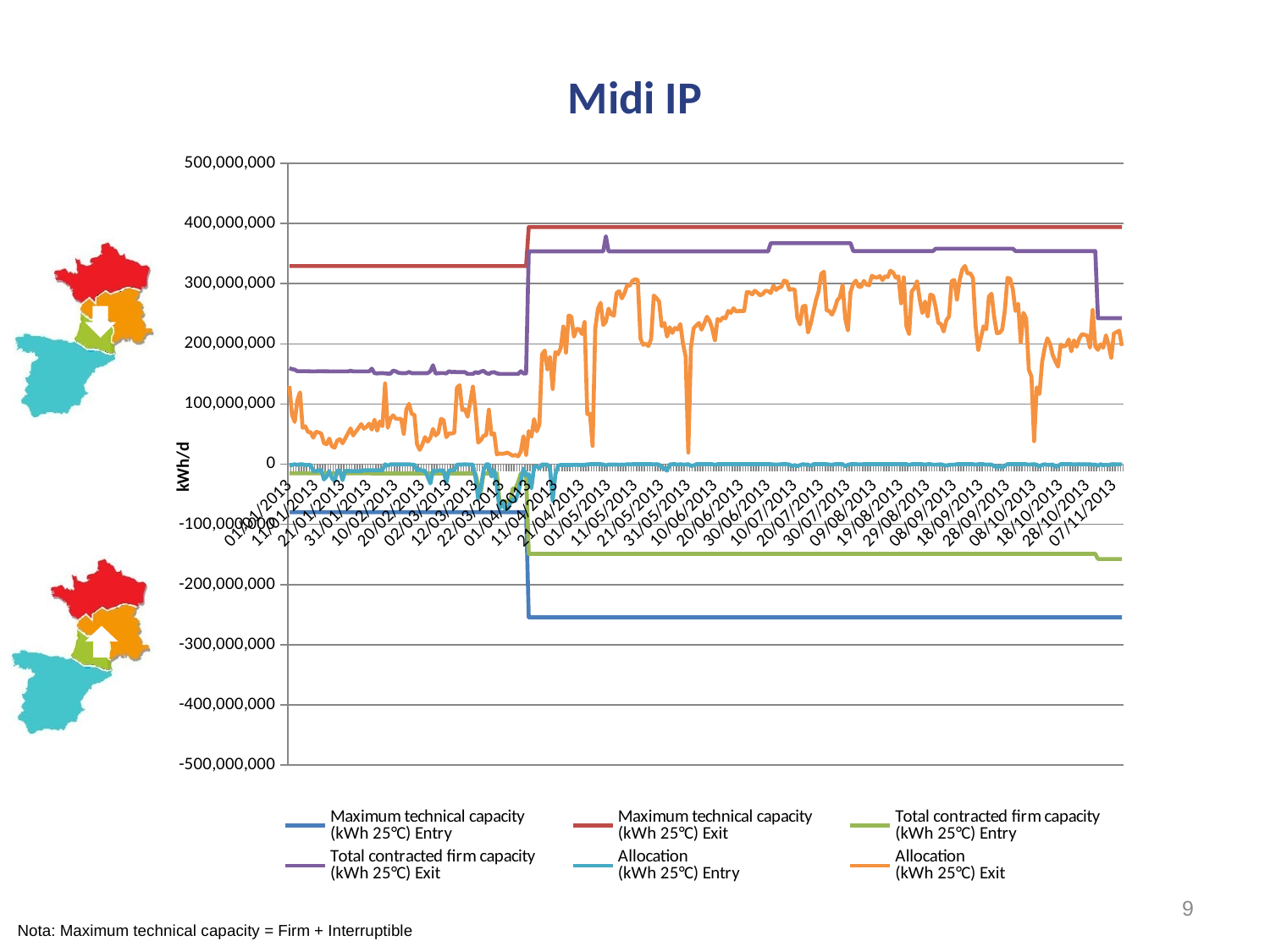
Is the value of Allocation (kWh 25°C) Exit in January 2013 greater or less than 200,000,000? less Is the value of Total contracted firm capacity (kWh 25°C) Exit in February 2013 greater or less than 100,000,000? greater In July 2013, which is larger: Maximum technical capacity (kWh 25°C) Exit or Total contracted firm capacity (kWh 25°C) Exit? Maximum technical capacity (kWh 25°C) Exit How many series does the legend list? 6 Which series has the lowest values on the chart? Maximum technical capacity (kWh 25°C) Entry What kind of chart is shown on the slide? line chart What is the label on the vertical axis? kWh/d Is the value of Maximum technical capacity (kWh 25°C) Entry in July 2013 greater or less than -200,000,000? less What is the title of the chart? Midi IP Which series has the highest values on the chart? Maximum technical capacity (kWh 25°C) Exit Does the Maximum technical capacity (kWh 25°C) Exit series rise or fall between March 2013 and May 2013? rise